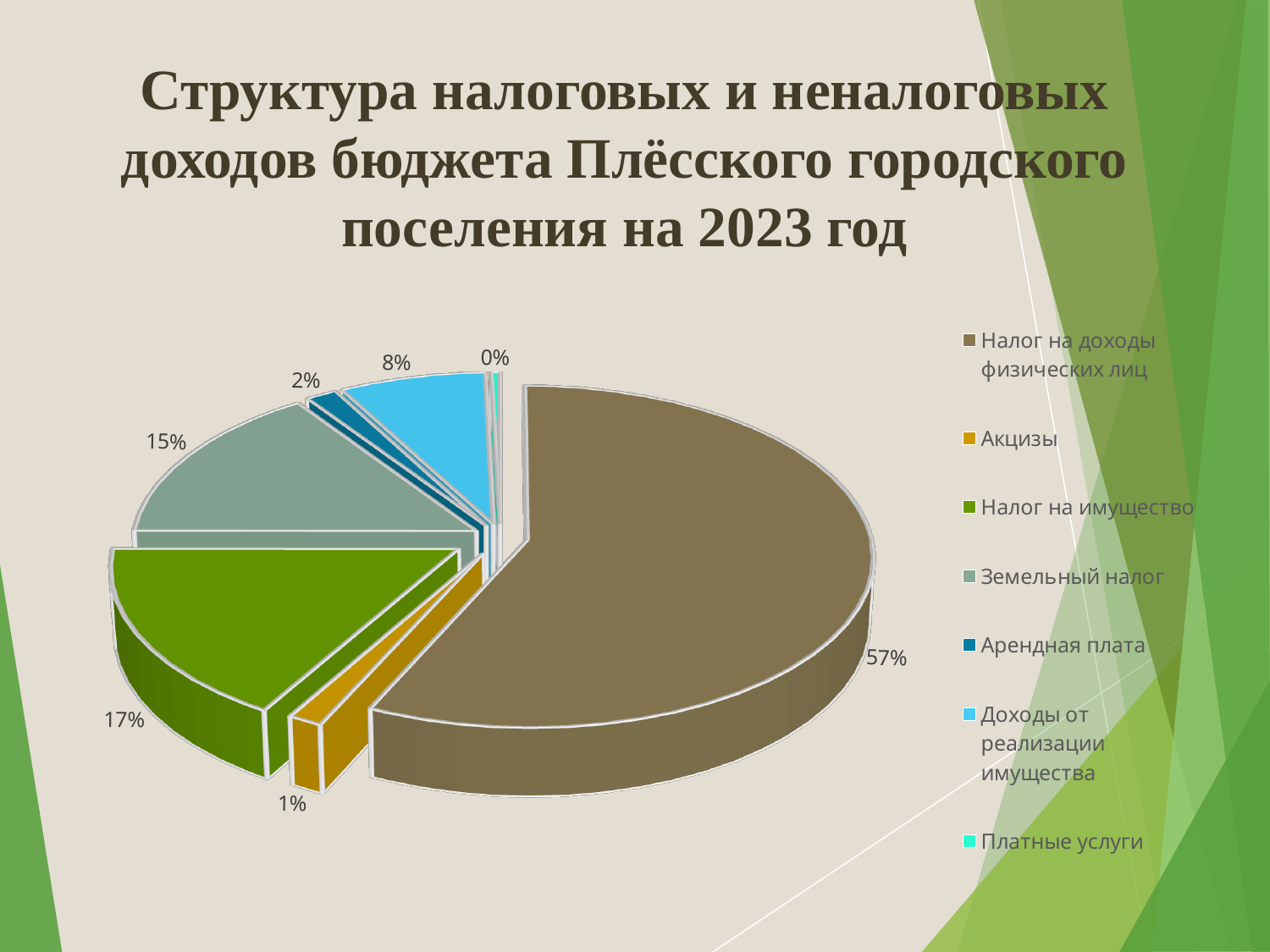
What share of the pie does Акцизы have? 1% What share of the pie does Налог на имущество have? 17% What share of the pie does Доходы от реализации имущества have? 8% Which is larger, the share for Арендная плата or the share for Доходы от реализации имущества? Доходы от реализации имущества What share of the pie does Налог на доходы физических лиц have? 57% How many categories does the legend list? 7 What kind of chart is shown on the slide? Pie chart Which category has the smallest slice of the pie? Платные услуги What is the difference in percentage points between Налог на имущество and Земельный налог? 2 Which category has the largest slice of the pie? Налог на доходы физических лиц What is the title of the slide? Структура налоговых и неналоговых доходов бюджета Плёсского городского поселения на 2023 год What share of the pie does Земельный налог have? 15%